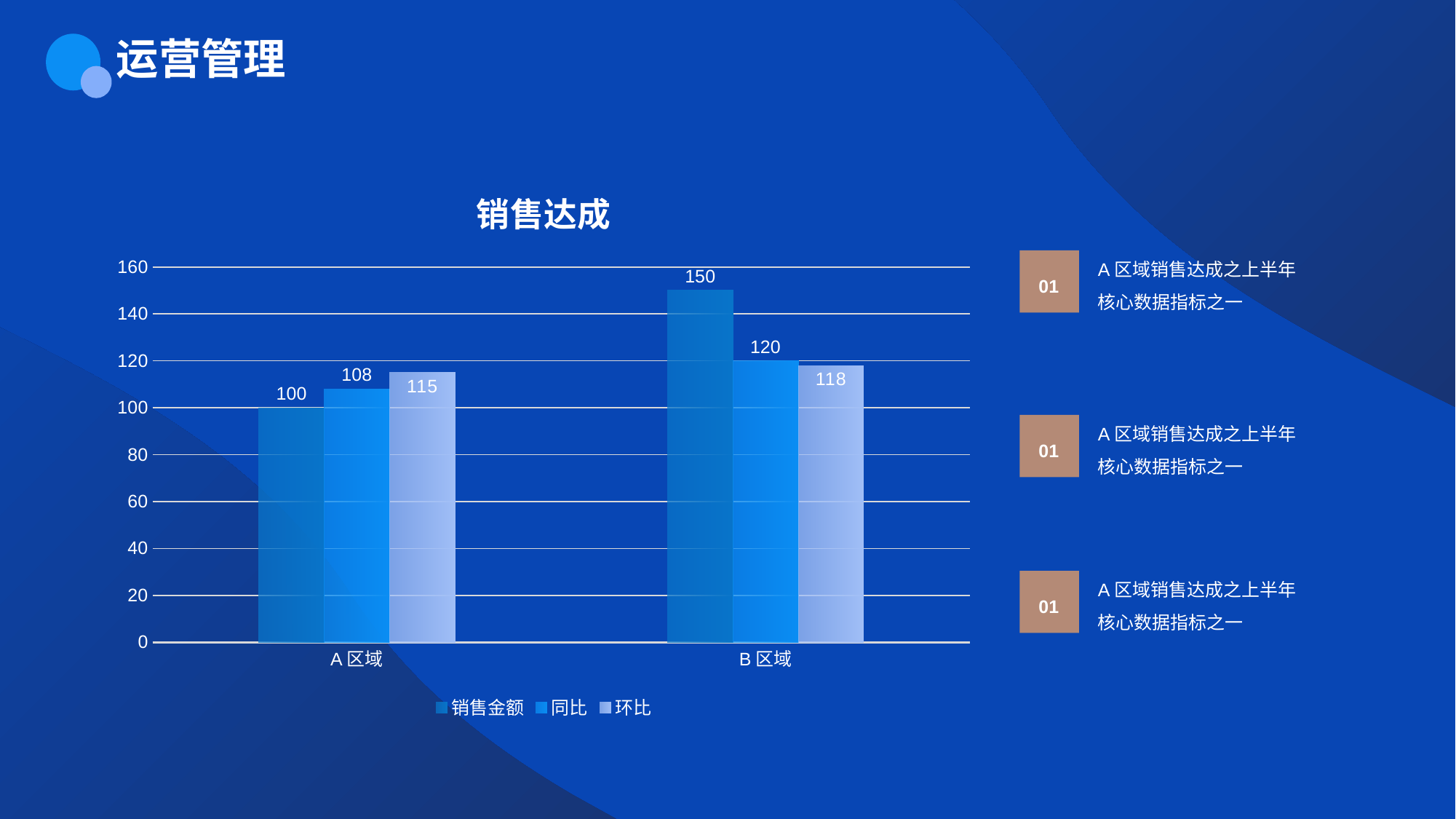
What is the difference between the 销售金额 values for B 区域 and A 区域? 50 Which is larger, the 环比 value for A 区域 or the 环比 value for B 区域? B 区域 What is the 环比 value for A 区域? 115 Which series has the lowest value for A 区域? 销售金额 What is the 销售金额 value for B 区域? 150 Which category has the highest 销售金额 value? B 区域 What is the 销售金额 value for A 区域? 100 Is the 销售金额 value for B 区域 greater or less than 140? greater What is the 同比 value for B 区域? 120 What type of chart is shown on the slide? Bar chart How many categories are shown on the x axis? 2 How many series does the legend list? 3